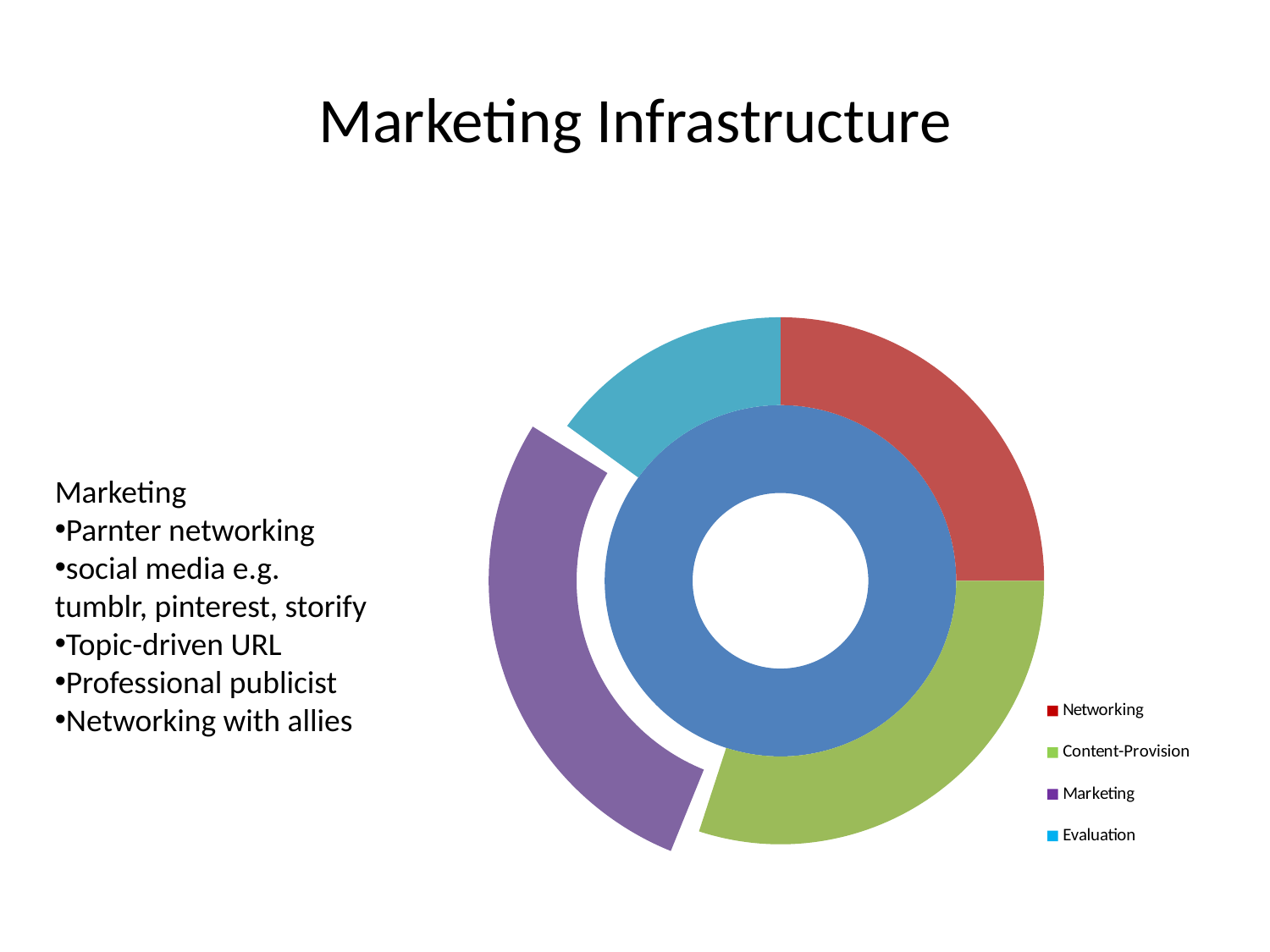
What kind of chart is shown on the slide? Doughnut chart What colour is the Marketing segment in the doughnut chart? Purple Which segment is larger in the outer ring: Content-Provision or Evaluation? Content-Provision Which segment of the outer ring is pulled away (exploded) from the rest of the doughnut chart? Marketing How many categories does the legend of the doughnut chart list? 4 Which segment is larger in the outer ring: Marketing or Evaluation? Marketing Which segment is larger in the outer ring: Networking or Evaluation? Networking Which category has the smallest segment in the outer ring of the doughnut chart? Evaluation